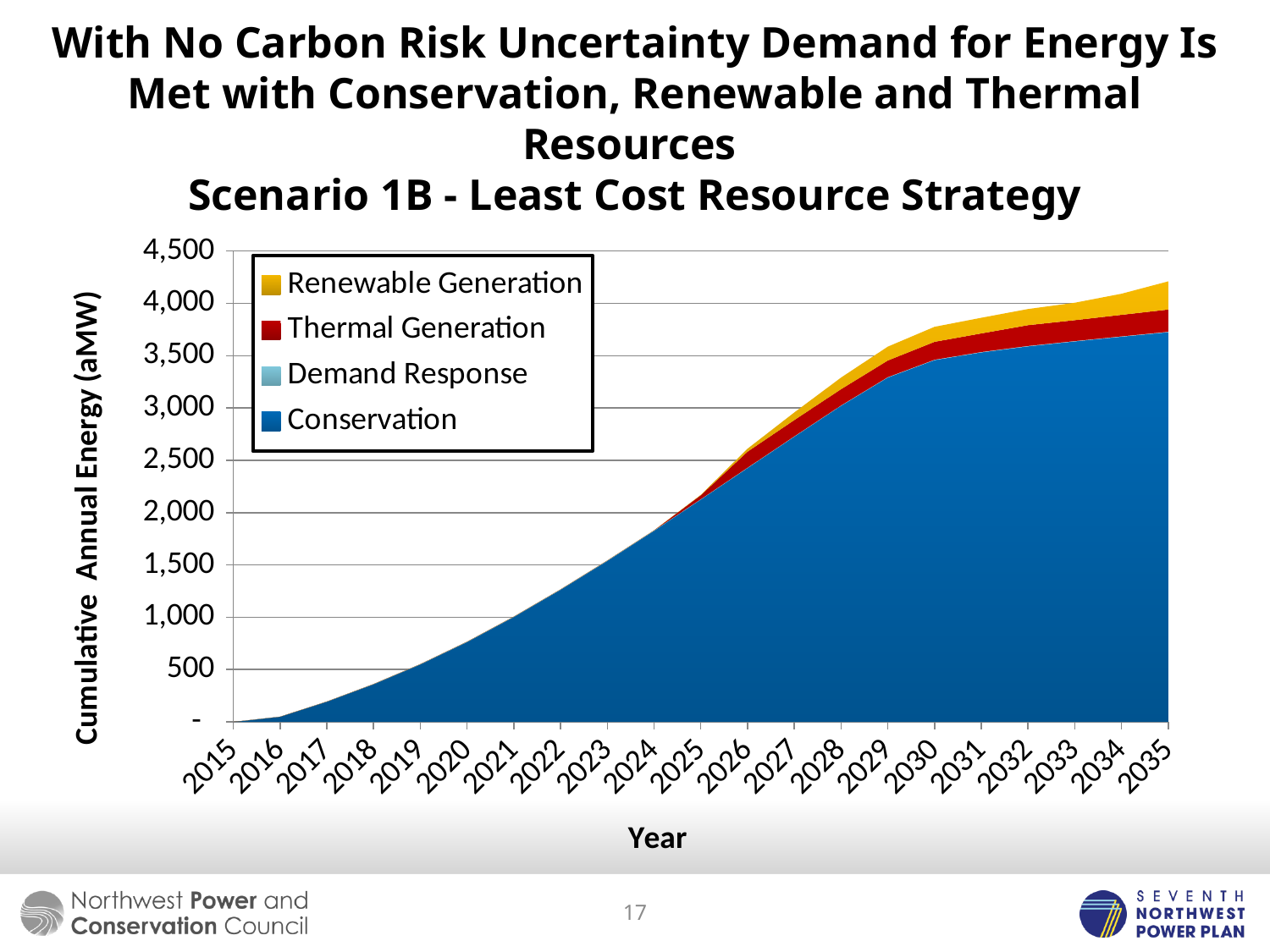
Is the total cumulative energy in 2020 greater or less than 1,000 aMW? less Do the cumulative energy values rise or fall from 2015 to 2035? Rise Is the Conservation value in 2035 greater or less than 3,500 aMW? greater Which series contributes the most cumulative energy in 2035? Conservation Is the total cumulative energy in 2018 greater or less than 500 aMW? less What is the label of the y axis? Cumulative Annual Energy (aMW) Which series is shown in yellow in the legend? Renewable Generation How many years are shown along the x axis? 21 What kind of chart is shown on the slide? Stacked area chart How many series does the legend list? 4